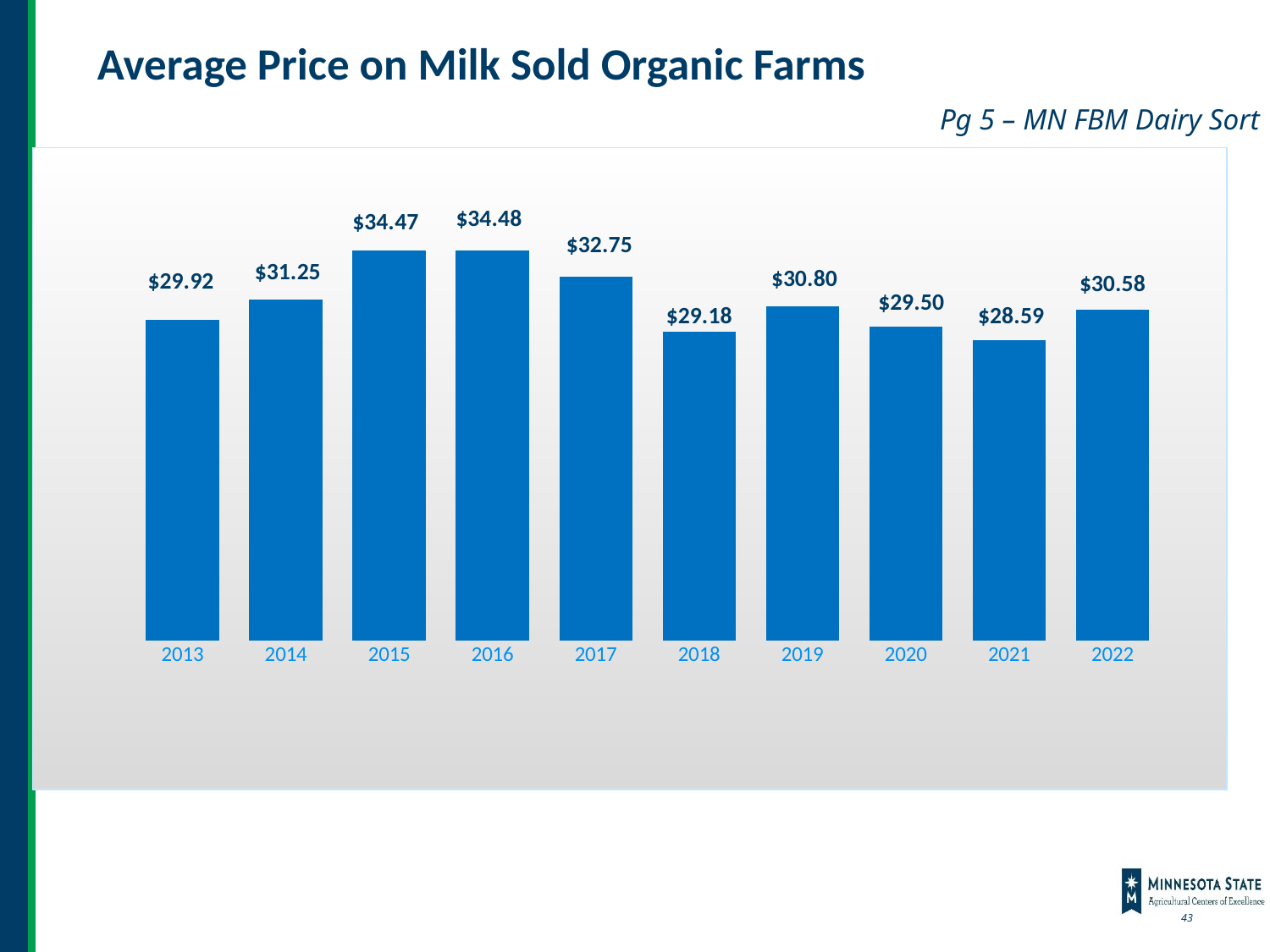
What is the title of the chart? Average Price on Milk Sold Organic Farms What kind of chart is shown on the slide? Bar chart What was the average price on milk sold for organic farms in 2015? $34.47 What value is shown for 2018? $29.18 Which year has the lowest average milk price? 2021 What is the difference between the 2015 value and the 2013 value? $4.55 How much higher is the 2017 value than the 2018 value? $3.57 How many years are shown on the chart? 10 What was the average milk price in 2022? $30.58 Which is larger, the value for 2013 or the value for 2020? 2013 Do the values rise or fall from 2016 to 2018? Fall Which year has the larger value, 2017 or 2022? 2017